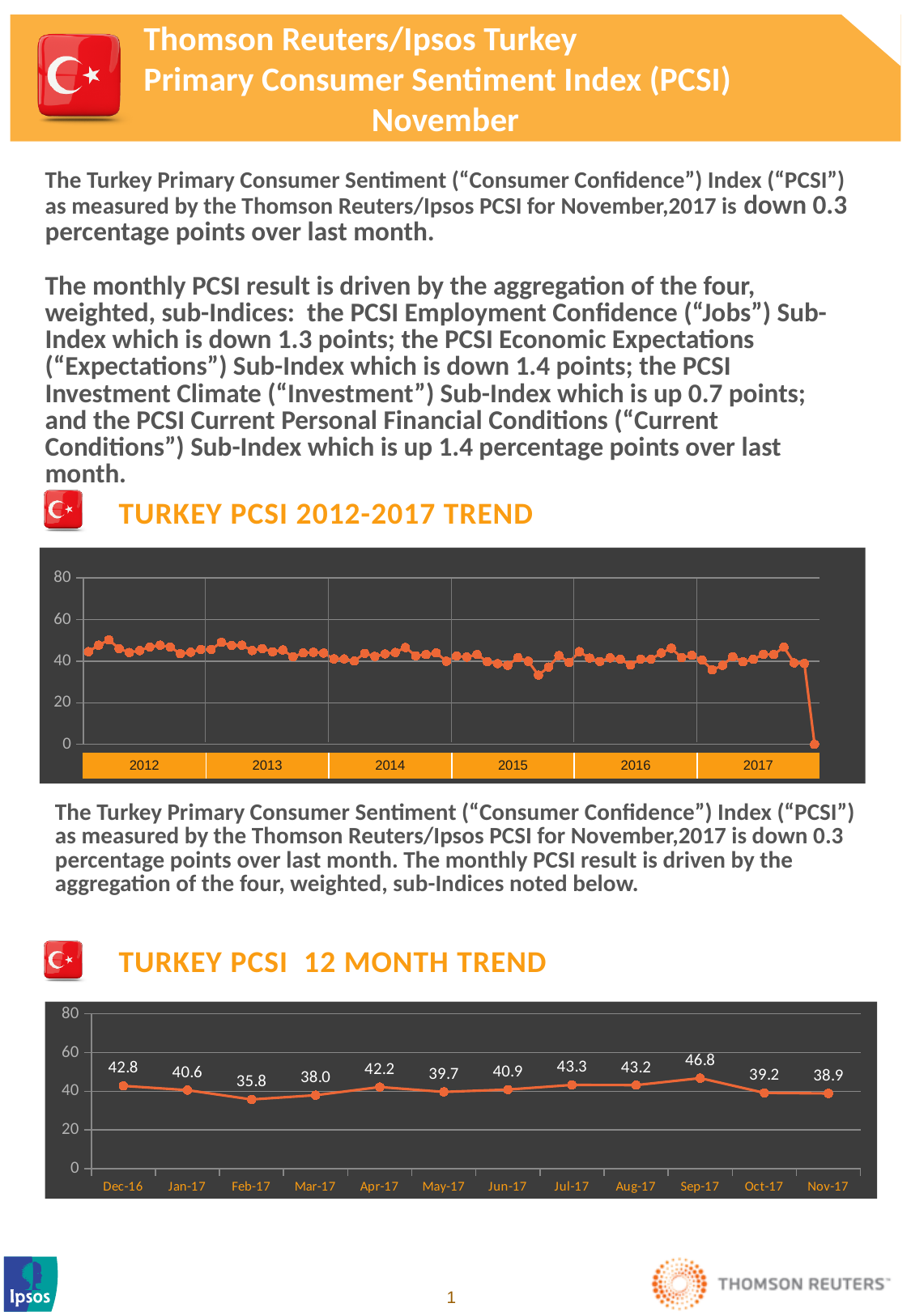
How many months are plotted in the TURKEY PCSI 12 MONTH TREND chart? 12 In the TURKEY PCSI 12 MONTH TREND chart, what is the value for Feb-17? 35.8 In the TURKEY PCSI 12 MONTH TREND chart, what is the difference between the Dec-16 and Nov-17 values? 3.9 In the TURKEY PCSI 12 MONTH TREND chart, which is larger, the value for Apr-17 or May-17? Apr-17 How many year labels appear along the x axis of the TURKEY PCSI 2012-2017 TREND chart? 6 In the TURKEY PCSI 12 MONTH TREND chart, which month has the lowest value? Feb-17 In the TURKEY PCSI 12 MONTH TREND chart, what is the value for Nov-17? 38.9 In the TURKEY PCSI 12 MONTH TREND chart, what is the difference between the Sep-17 and Oct-17 values? 7.6 In the TURKEY PCSI 12 MONTH TREND chart, which month has the highest value? Sep-17 What kind of chart is the TURKEY PCSI 2012-2017 TREND chart? Line chart In the TURKEY PCSI 2012-2017 TREND chart, is the highest point in 2012 greater or less than 60? less In the TURKEY PCSI 12 MONTH TREND chart, what is the value for Sep-17? 46.8